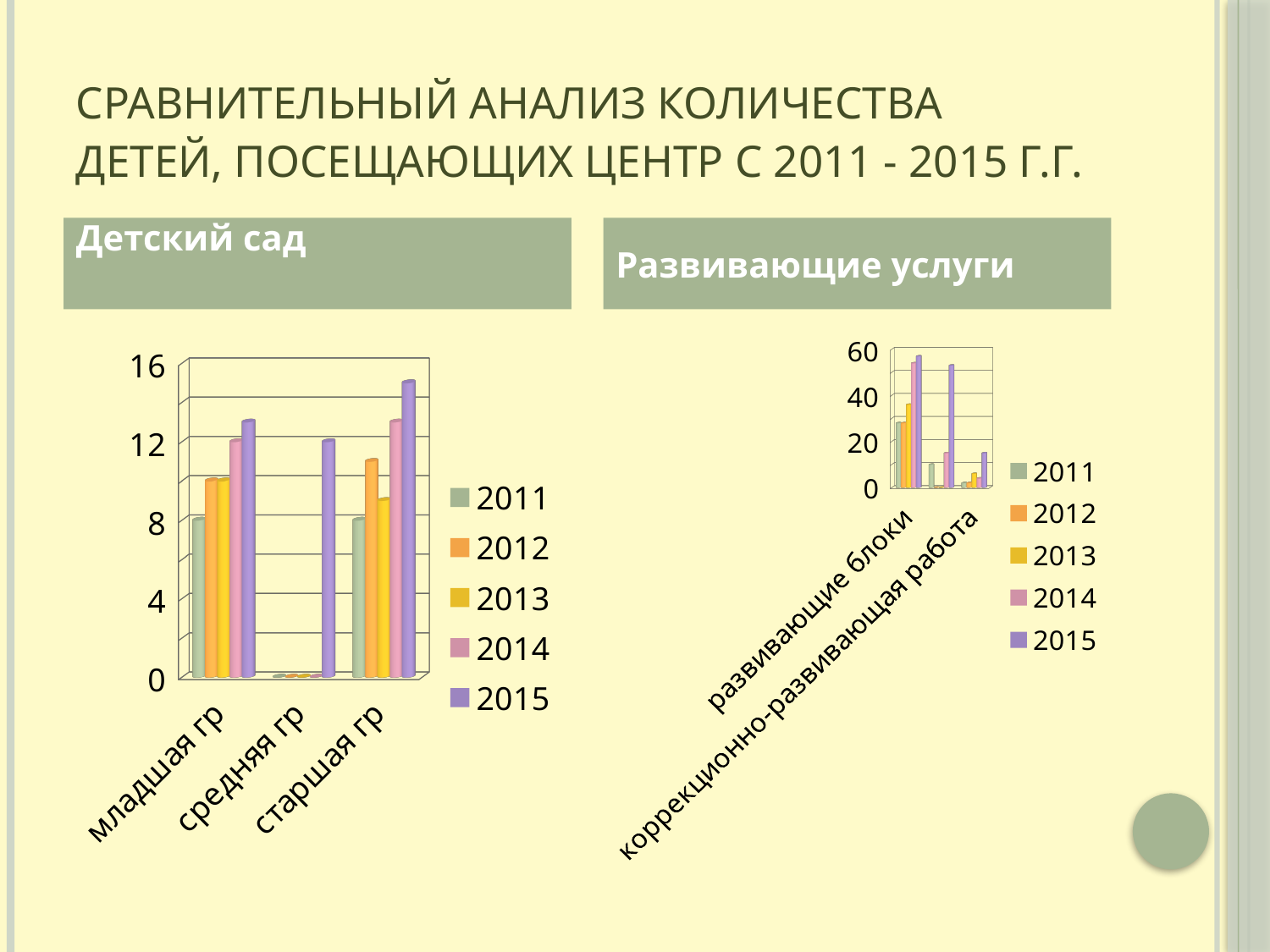
In the "Детский сад" chart, which category has the highest 2015 value? старшая гр In the "Развивающие услуги" chart, is the value for 2011 in "развивающие блоки" greater or less than 40? less In the "Детский сад" chart, what is the value for 2011 in "младшая гр"? 8 How many categories are shown on the x axis of the "Детский сад" chart? 3 In the "Детский сад" chart, which category has the lowest 2011 value? средняя гр What kind of chart is the "Детский сад" chart? bar chart In the "Детский сад" chart, is the value for 2014 in "средняя гр" greater or less than 4? less In the "Развивающие услуги" chart, is the value for 2015 in "развивающие блоки" greater or less than 40? greater In the "Детский сад" chart, which is larger: the 2015 value for "младшая гр" or the 2015 value for "старшая гр"? старшая гр How many series does the legend of the "Детский сад" chart list? 5